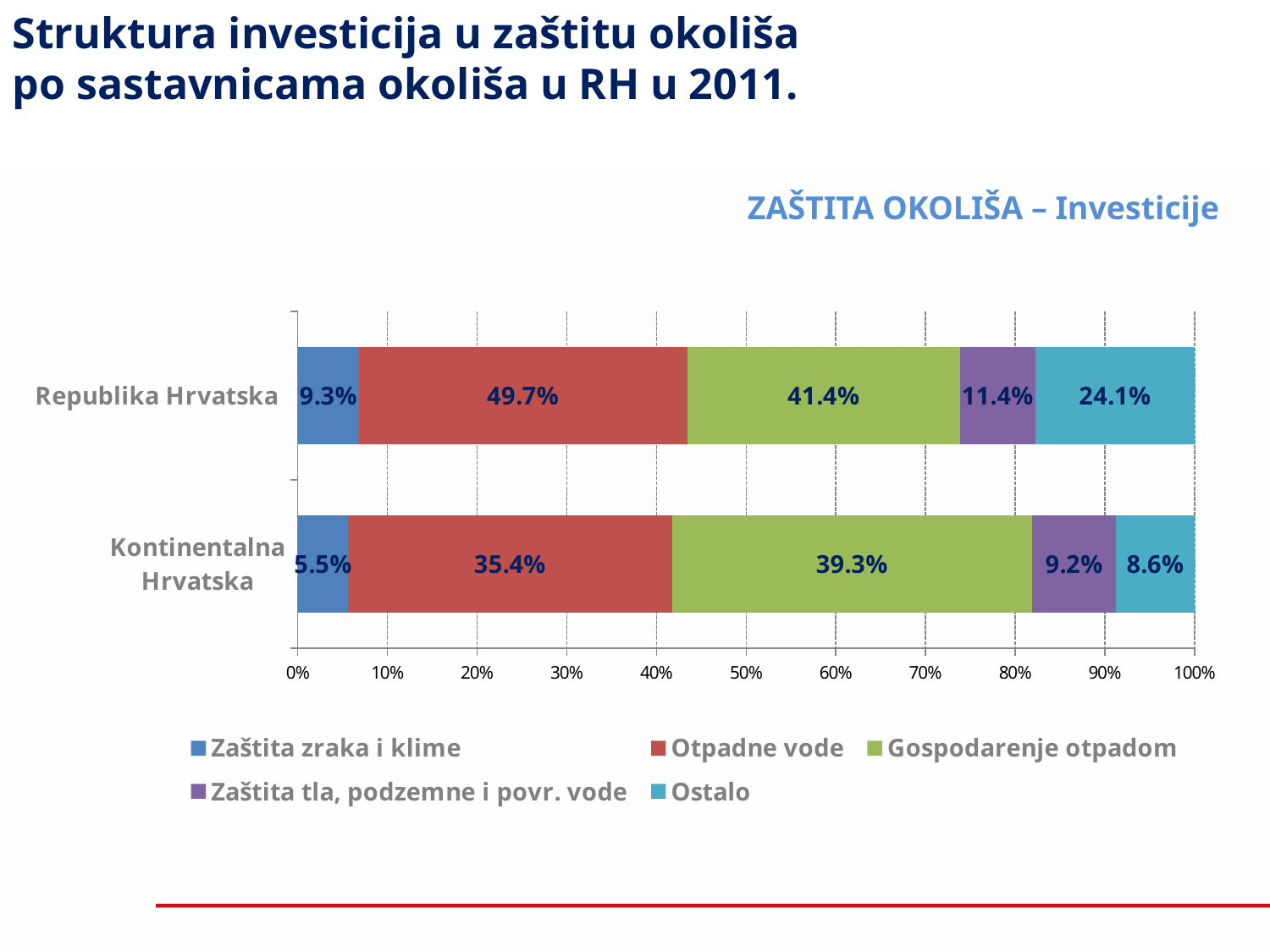
What kind of chart is shown on the slide? Stacked bar chart Which series has the lowest labelled value in the Republika Hrvatska bar? Zaštita zraka i klime What is the value for Zaštita zraka i klime in the Kontinentalna Hrvatska bar? 5.5% What is the value for Zaštita tla, podzemne i povr. vode in the Republika Hrvatska bar? 11.4% What is the difference between the Otpadne vode values for Republika Hrvatska and Kontinentalna Hrvatska? 14.3% What is the value for Ostalo in the Republika Hrvatska bar? 24.1% Which is larger: the Ostalo value for Republika Hrvatska or for Kontinentalna Hrvatska? Republika Hrvatska How many categories (bars) are shown on the chart? 2 How many series does the legend list? 5 What is the value for Gospodarenje otpadom in the Kontinentalna Hrvatska bar? 39.3% What is the value for Otpadne vode in the Republika Hrvatska bar? 49.7% Which series has the highest labelled value in the Kontinentalna Hrvatska bar? Gospodarenje otpadom